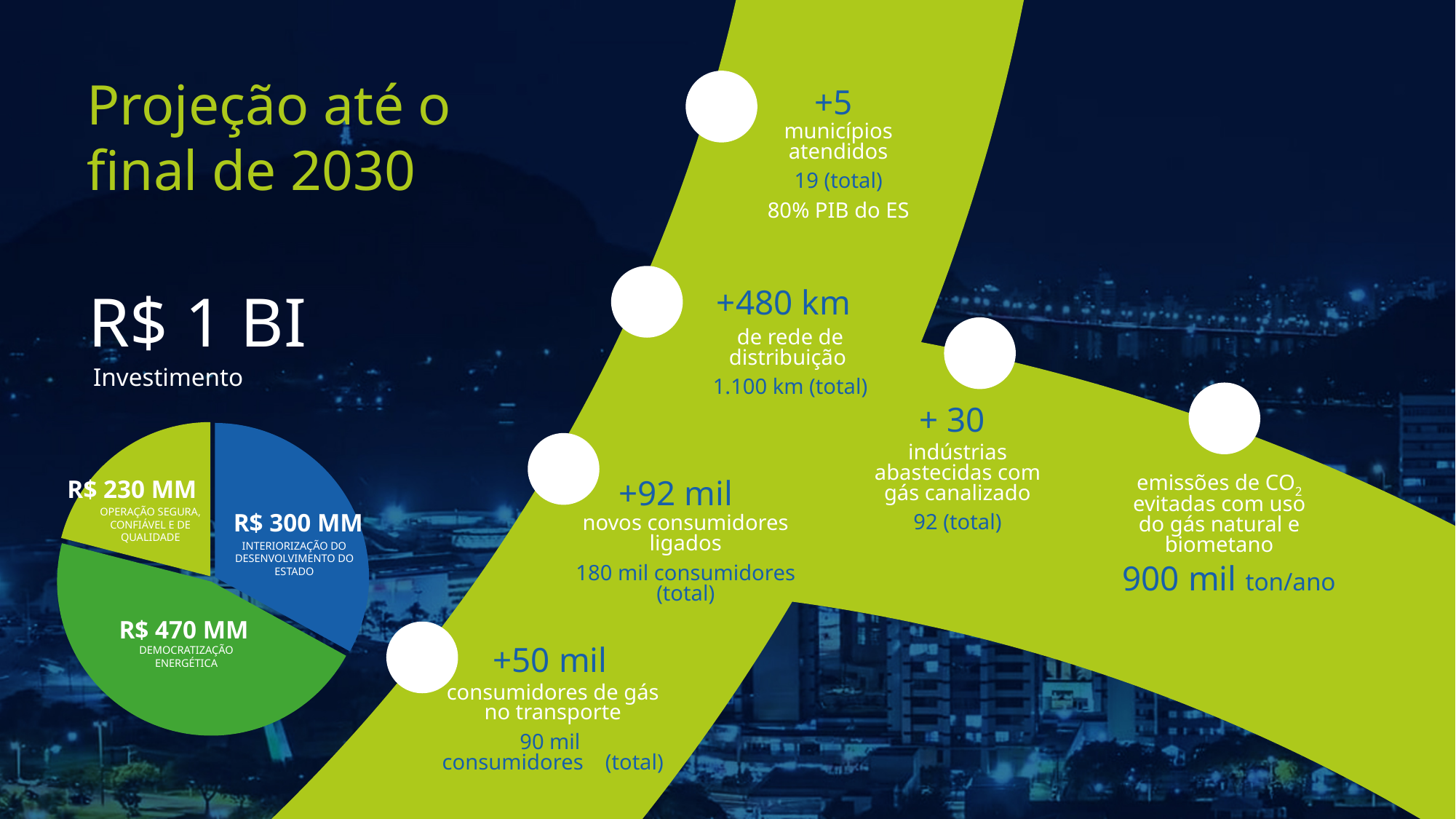
Which slice of the pie chart is the smallest? Operação Segura, Confiável e de Qualidade How many slices does the pie chart have? 3 What is the value of the Interiorização do Desenvolvimento do Estado slice? R$ 300 MM What is the difference between the Democratização Energética slice and the Interiorização do Desenvolvimento do Estado slice? R$ 170 MM What is the total of the three slices in the pie chart? R$ 1.000 MM (R$ 1 BI) What share of the total investment does the Democratização Energética slice represent? 47% What colour is the Interiorização do Desenvolvimento do Estado slice? Blue What is the value of the Democratização Energética slice? R$ 470 MM Which slice of the pie chart is the largest? Democratização Energética What kind of chart is shown on the slide? Pie chart Which is larger: the Interiorização do Desenvolvimento do Estado slice or the Operação Segura, Confiável e de Qualidade slice? Interiorização do Desenvolvimento do Estado What is the value of the Operação Segura, Confiável e de Qualidade slice? R$ 230 MM